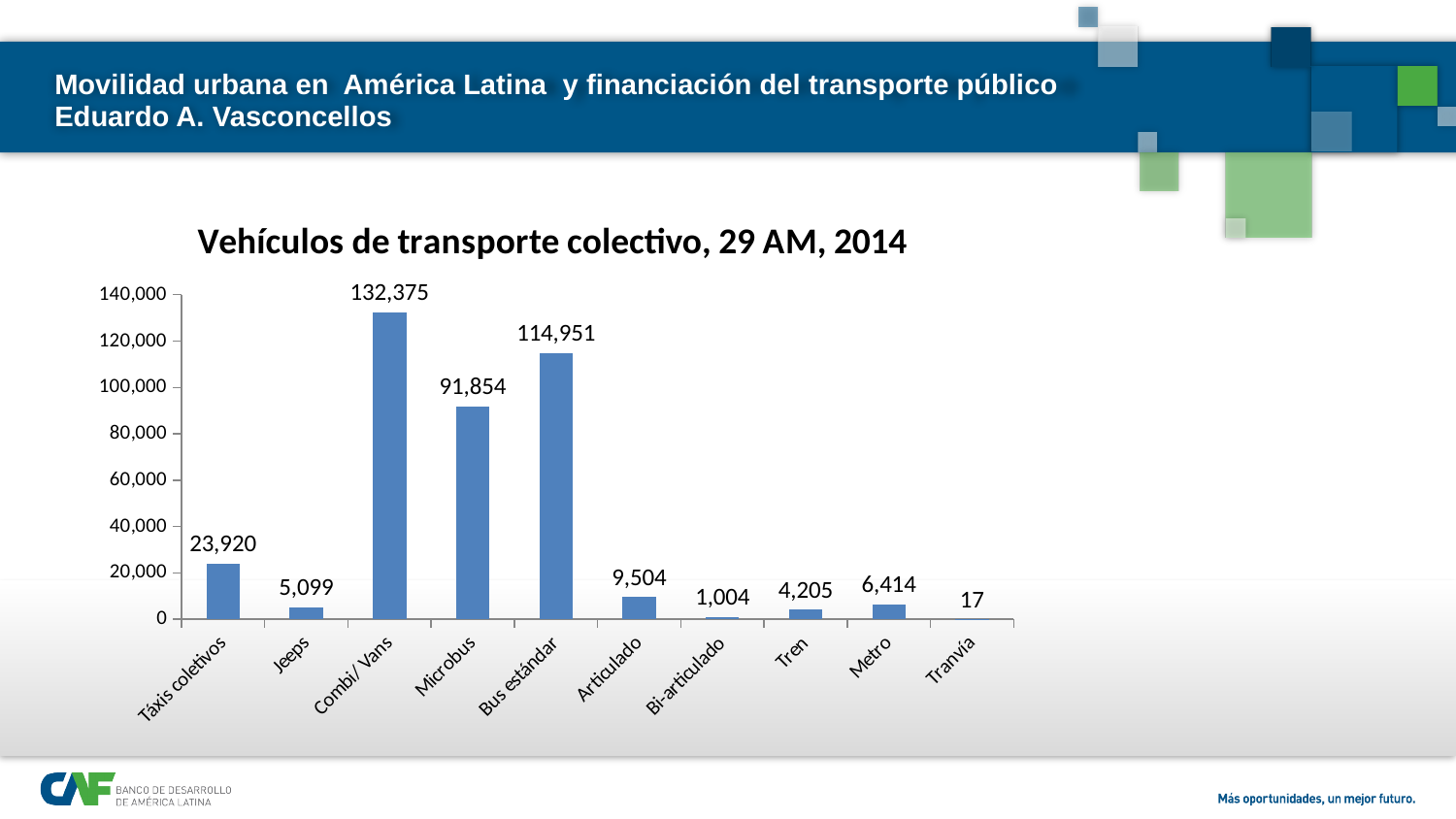
Which category has the lowest value? Tranvía What is the title of the chart? Vehículos de transporte colectivo, 29 AM, 2014 Which is larger, the value for Metro or the value for Tren? Metro Which category has the highest value? Combi/Vans What is the value for Tranvía? 17 What kind of chart is shown on the slide? Bar chart How many categories are shown on the x axis? 10 What is the value for Microbus? 91,854 What is the value for Combi/Vans? 132,375 What is the difference between the values for Táxis coletivos and Jeeps? 18,821 Is the value for Bus estándar greater or less than 100,000? greater What is the difference between the values for Combi/Vans and Bus estándar? 17,424